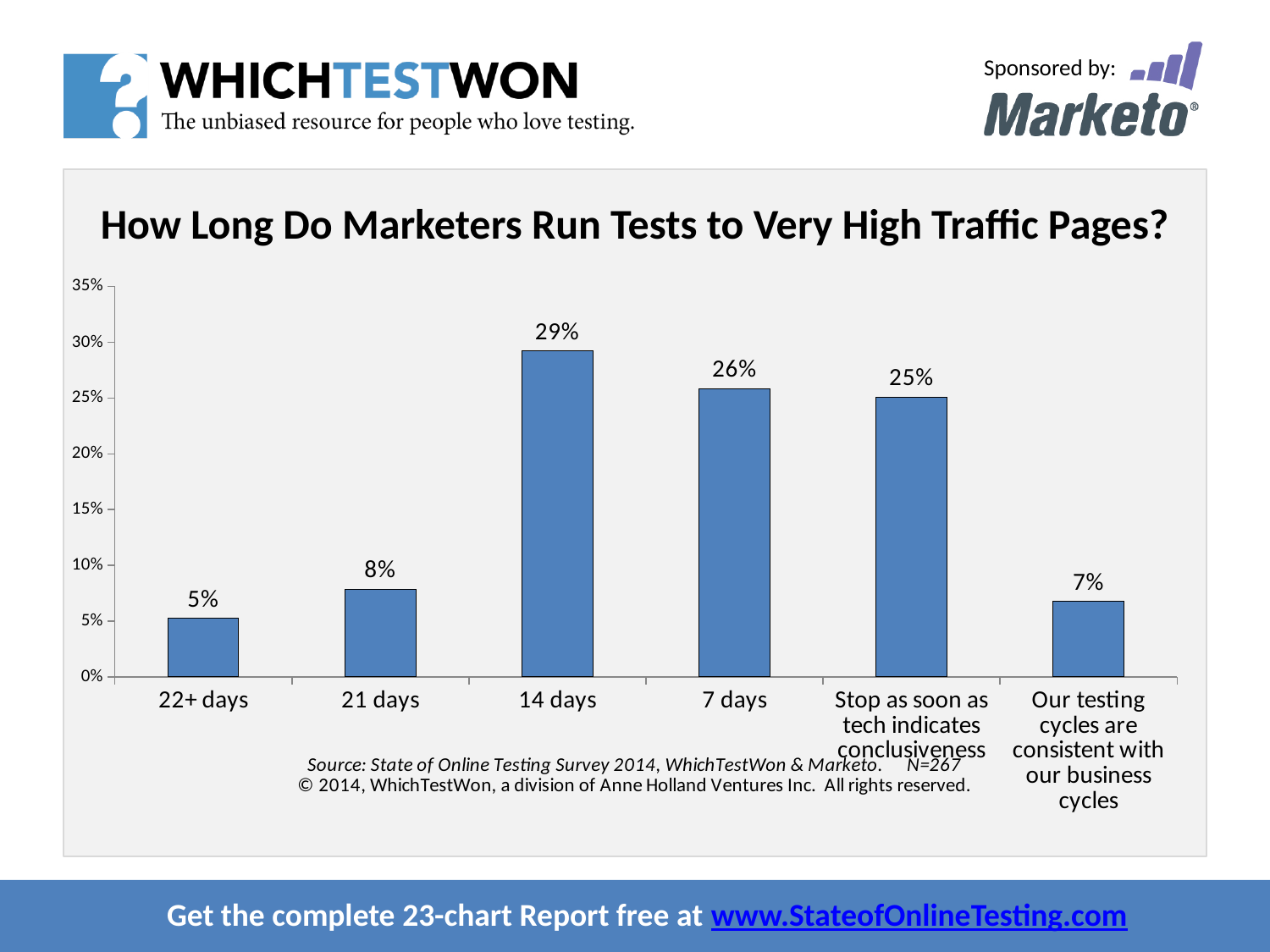
What is the value for the '22+ days' category? 5% How many categories are shown on the x axis? 6 What is the difference between the values for 14 days and 7 days? 3% What is the title of the chart? How Long Do Marketers Run Tests to Very High Traffic Pages? What percentage of marketers stop as soon as tech indicates conclusiveness? 25% Which category has the highest value? 14 days Which is larger, the value for 7 days or the value for 21 days? 7 days What is the difference between the values for 21 days and 22+ days? 3% What percentage of marketers run tests to very high traffic pages for 14 days? 29% What kind of chart is shown on the slide? Bar chart Which category has the lowest value? 22+ days What is the value for 'Our testing cycles are consistent with our business cycles'? 7%